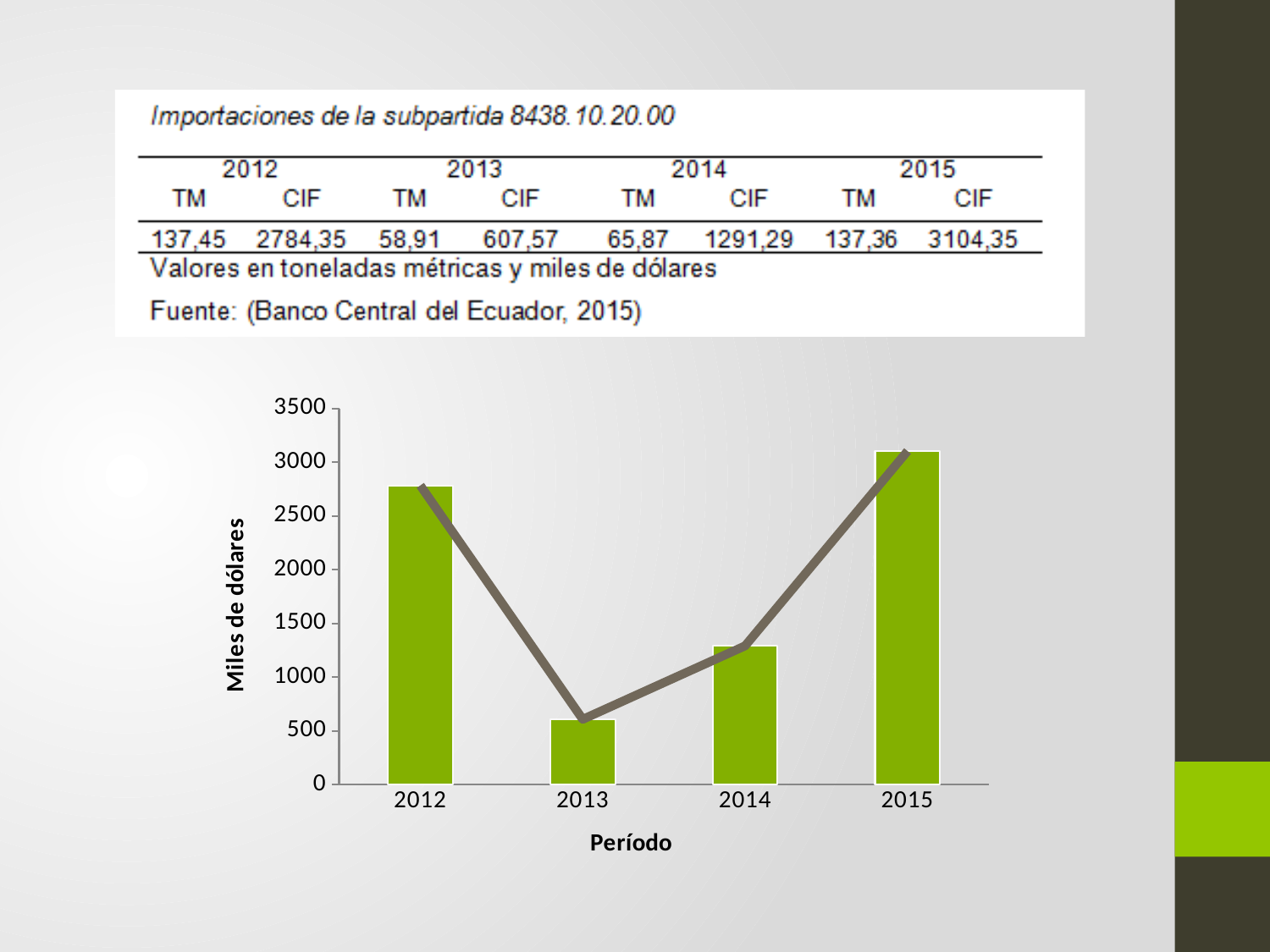
What is the title of the horizontal axis of the chart? Período How many years are shown on the x axis of the chart? 4 Is the value for 2012 greater or less than 2500? greater Is the value for 2015 greater or less than 3500? less Is the value for 2014 greater or less than 1000? greater Which year has the lowest bar in the chart? 2013 Do the values rise or fall from 2013 to 2015? rise What kind of chart is used for the green series? bar chart Is the bar for 2012 taller than the bar for 2014? Yes Which year has the highest bar in the chart? 2015 What is the title of the vertical axis of the chart? Miles de dólares